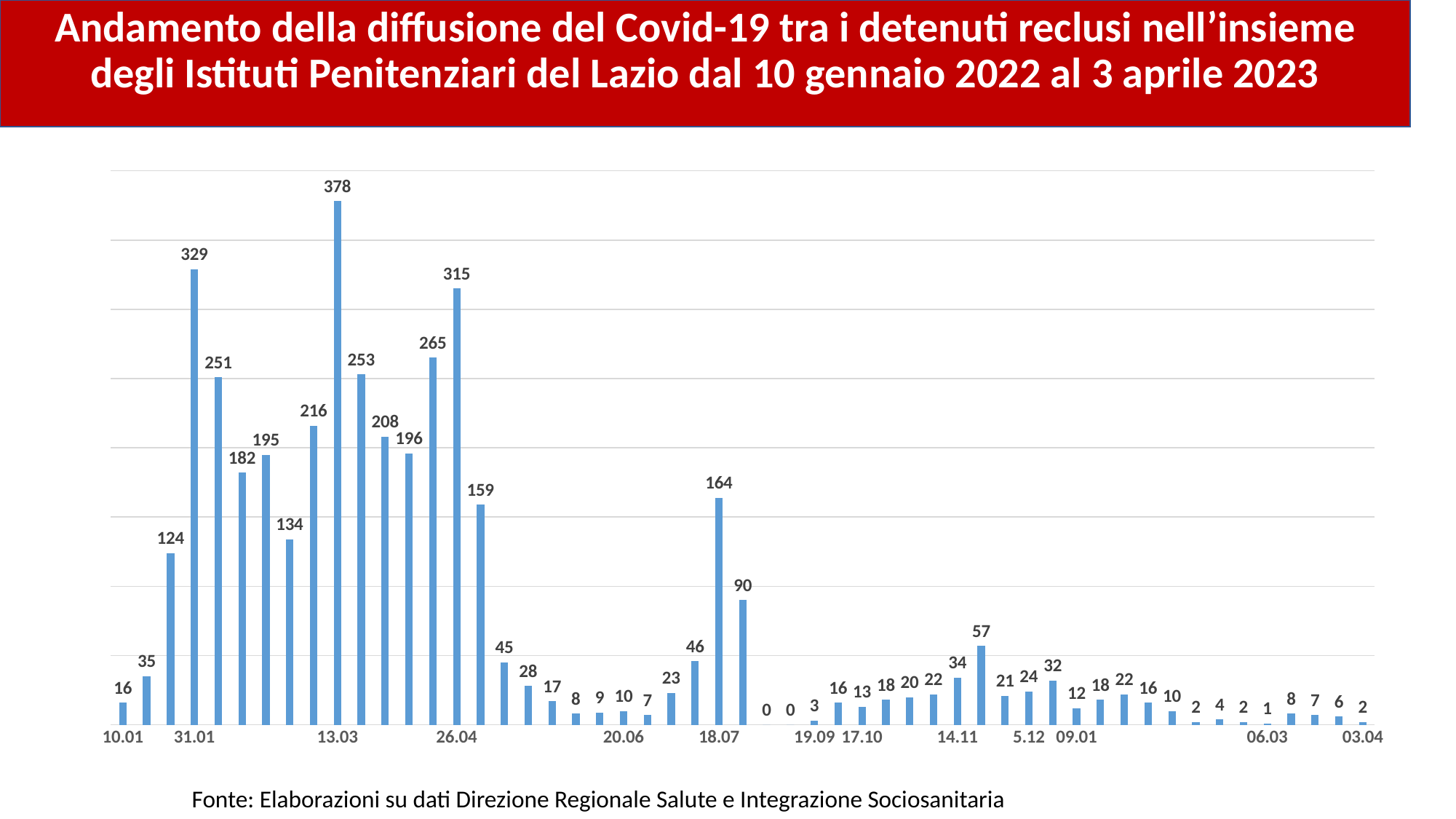
What is the difference between the values for 13.03 and 31.01? 49 Do the values rise or fall between 26.04 and 20.06? fall What is the lowest value shown in the chart? 0 What is the value for 31.01? 329 Which is larger, the value for 31.01 or the value for 26.04? 31.01 What is the value for 18.07? 164 Which date has the highest value in the chart? 13.03 What is the value for 10.01? 16 What source is cited below the chart? Elaborazioni su dati Direzione Regionale Salute e Integrazione Sociosanitaria What is the value for 03.04? 2 What is the value for 13.03? 378 What kind of chart is shown on the slide? bar chart